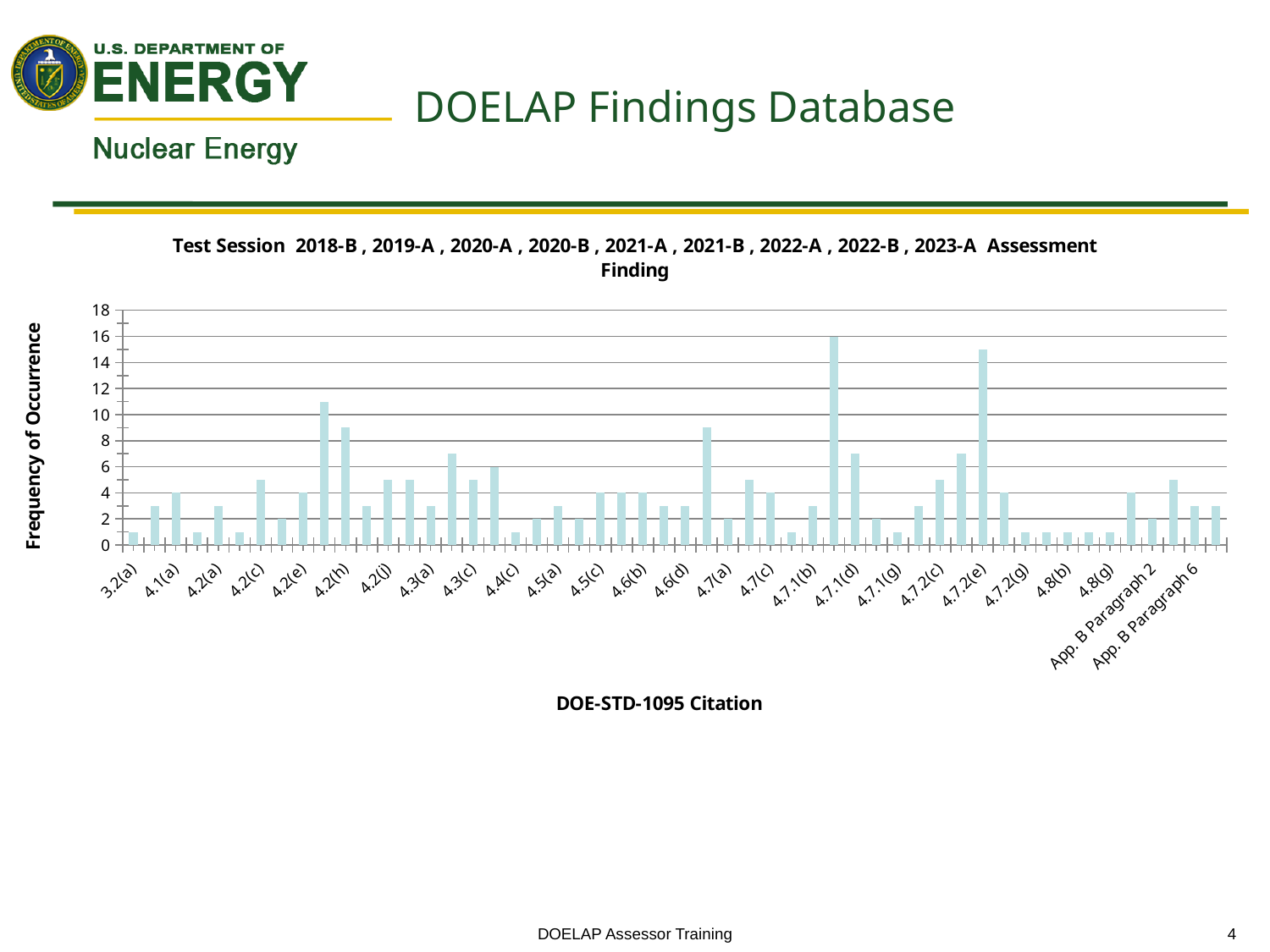
Is the value for citation 4.7.1(d) greater or less than 6? greater What is the frequency of occurrence for citation 4.1(a)? 4 Which has the higher frequency of occurrence, citation 4.7.1(d) or citation 4.7.2(g)? 4.7.1(d) Is the value for citation 4.7.2(e) greater or less than 10? greater Is the value for citation 4.7.1(g) greater or less than 2? less What is the title of the y axis on the chart? Frequency of Occurrence What is the frequency of occurrence for App. B Paragraph 2? 2 Which has the higher frequency of occurrence, citation 4.2(h) or citation 4.2(c)? 4.2(h) What kind of chart is shown on the slide? bar chart What is the title of the x axis on the chart? DOE-STD-1095 Citation What is the frequency of occurrence for citation 4.7(c)? 4